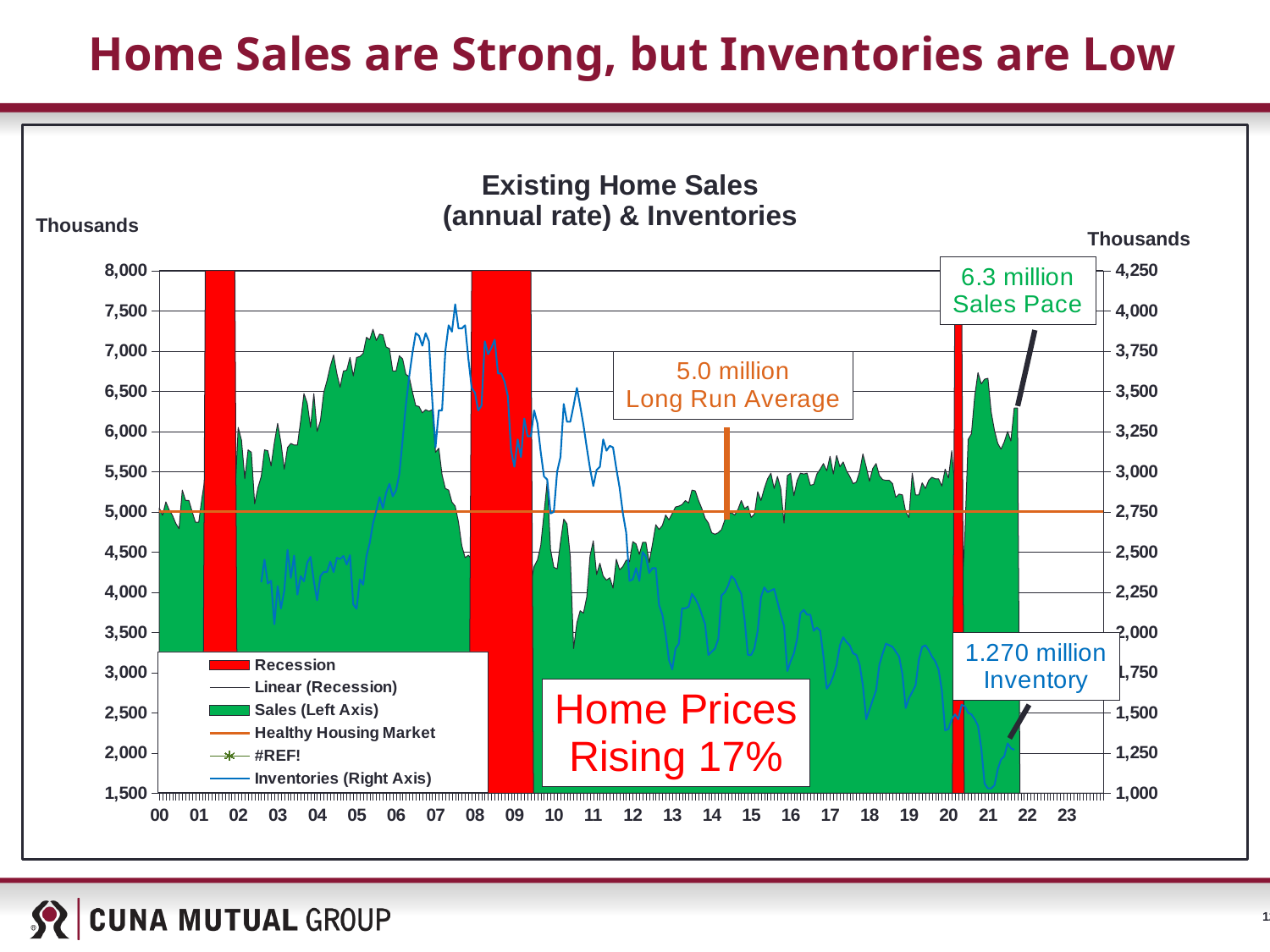
Which is higher, Sales around 2005 or Sales around 2010? Sales around 2005 How many entries does the chart legend list? 6 What inventory level is called out for the latest data point on the chart? 1.270 million At what level on the left axis does the Healthy Housing Market line sit? 5,000 Is the peak of Sales around 2005 greater or less than 7,000 on the left axis? greater Do Inventories generally rise or fall from 2007 to 2021? fall By what percentage does the chart say home prices are rising? 17% What value does the chart give for the long run average of home sales? 5.0 million What sales pace is called out for the latest data point on the chart? 6.3 million Is the peak of Inventories around 2007 greater or less than 3,500 on the right axis? greater What is the title of the chart? Existing Home Sales (annual rate) & Inventories How many recession bands are shaded on the chart? 3